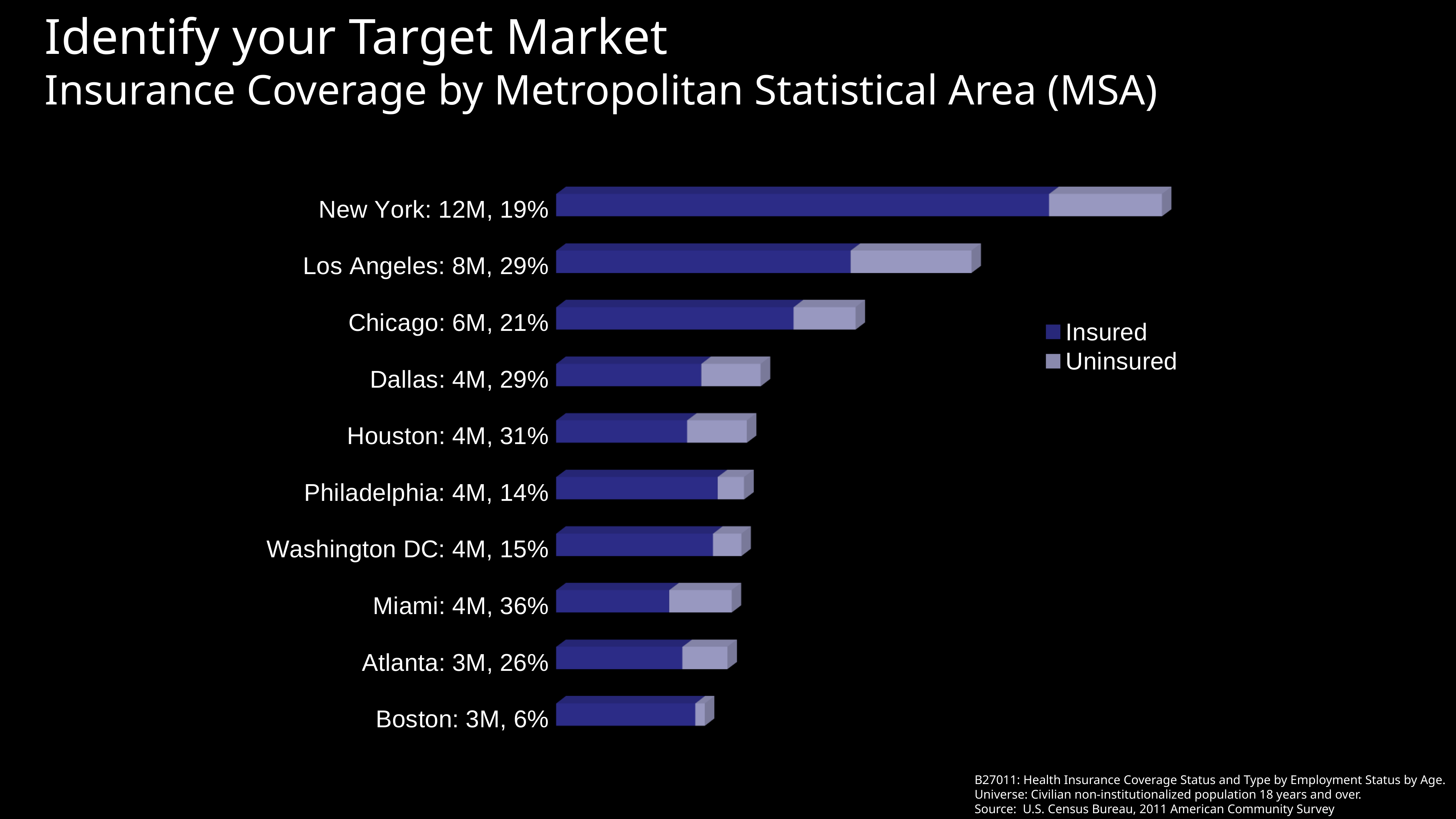
What kind of chart is shown on the slide? bar chart What uninsured percentage is printed in the label for Miami? 36% Which has the longer total bar, Los Angeles or Chicago? Los Angeles How many metropolitan areas are listed in the chart? 10 What is the difference between the uninsured percentages printed for Miami and Boston? 30 percentage points What are the two series named in the legend? Insured and Uninsured What uninsured percentage is printed in the label for Washington DC? 15% Which metropolitan area has the highest uninsured percentage in its label? Miami Which metropolitan area has the lowest uninsured percentage in its label? Boston What population figure is printed in the label for Chicago? 6M How many series does the legend list? 2 Which metropolitan area has the longest total bar? New York